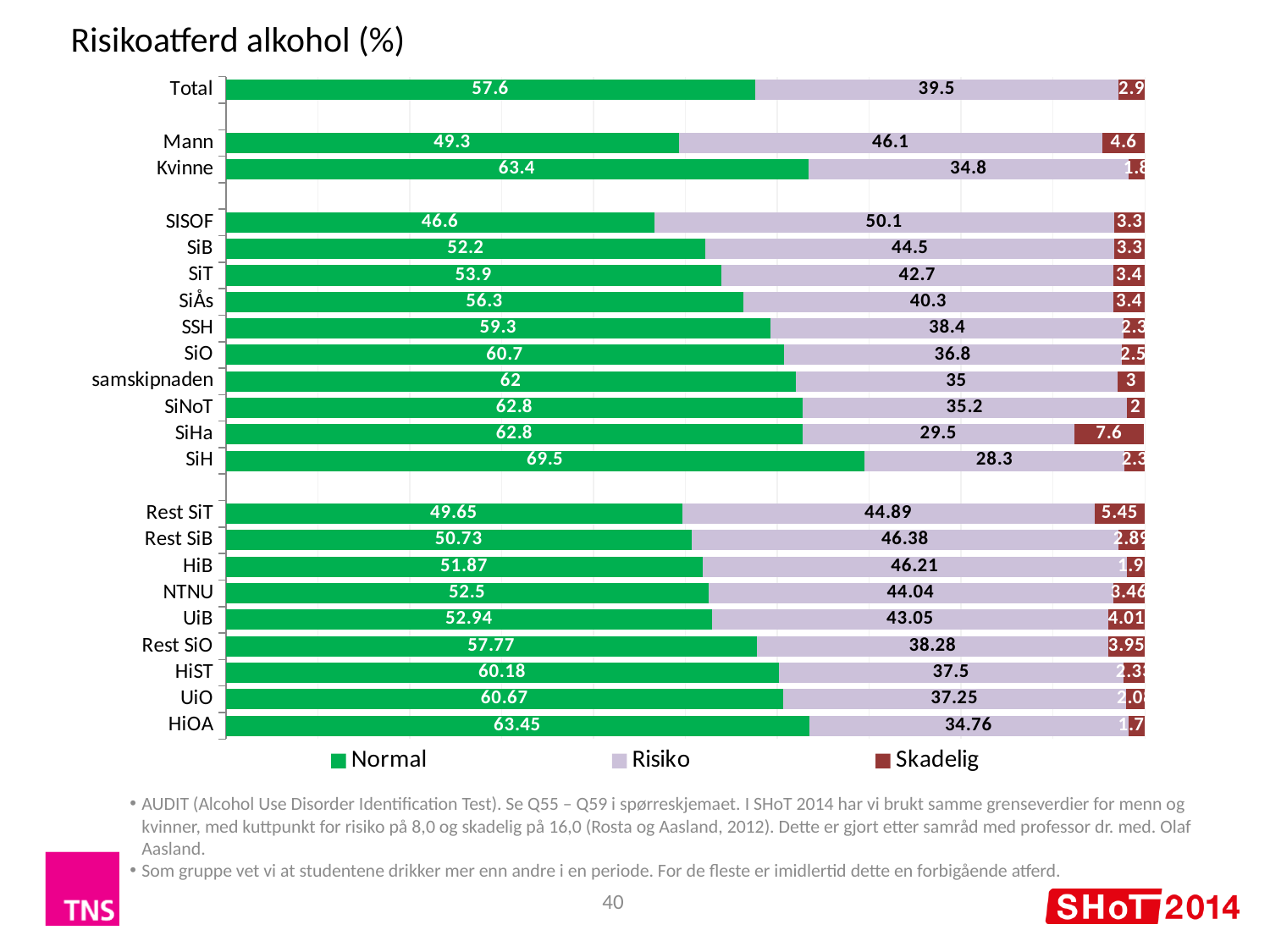
What is the Skadelig value for SiHa? 7.6 What is the Risiko value for SISOF? 50.1 Which category has the lowest Normal value? SISOF What is the Risiko value for Mann? 46.1 What is the Normal value for Total? 57.6 What is the total of the stacked bar for Total? 100 Which category has the highest Skadelig value? SiHa What kind of chart is shown on the slide? Stacked bar chart How many series does the legend list? 3 Which has the larger Risiko value, SiB or SiT? SiB What is the difference between the Normal values for Kvinne and Mann? 14.1 Which category has the highest Normal value? SiH